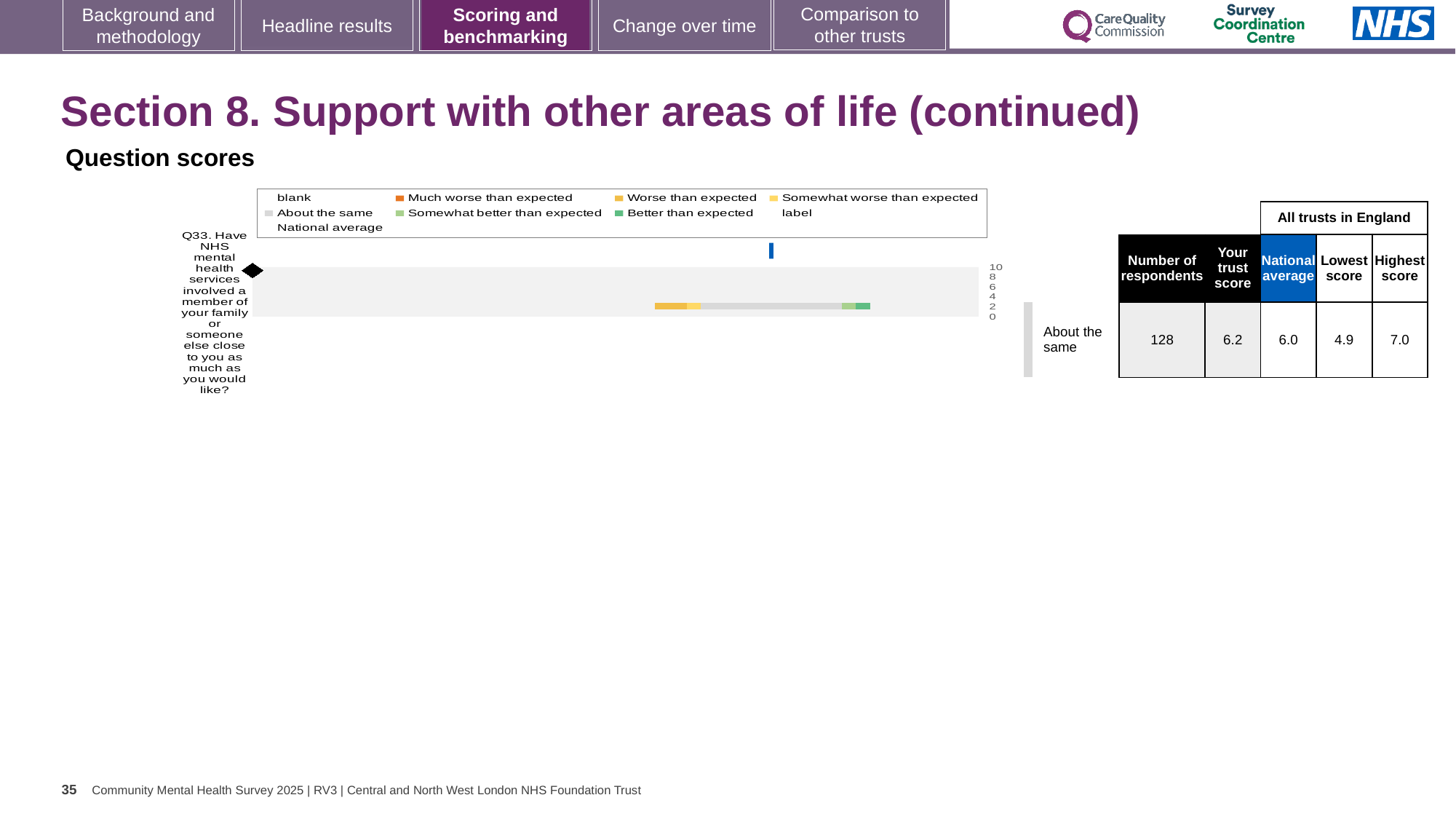
What is the highest value shown on the chart's axis? 10 Which question is plotted on the chart? Q33. Have NHS mental health services involved a member of your family or someone else close to you as much as you would like? How many entries does the chart legend list? 9 How many questions (categories) are plotted on the chart? 1 What is the difference between the highest and lowest scores among all trusts in England for Q33? 2.1 Which is larger for Q33: the trust's score or the national average? the trust's score What is the trust's score for Q33 according to the table next to the chart? 6.2 What kind of chart is shown on the slide? bar chart How many respondents answered Q33? 128 What is the lowest score among all trusts in England for Q33? 4.9 What is the highest score among all trusts in England for Q33? 7.0 What is the national average score for Q33 according to the table next to the chart? 6.0